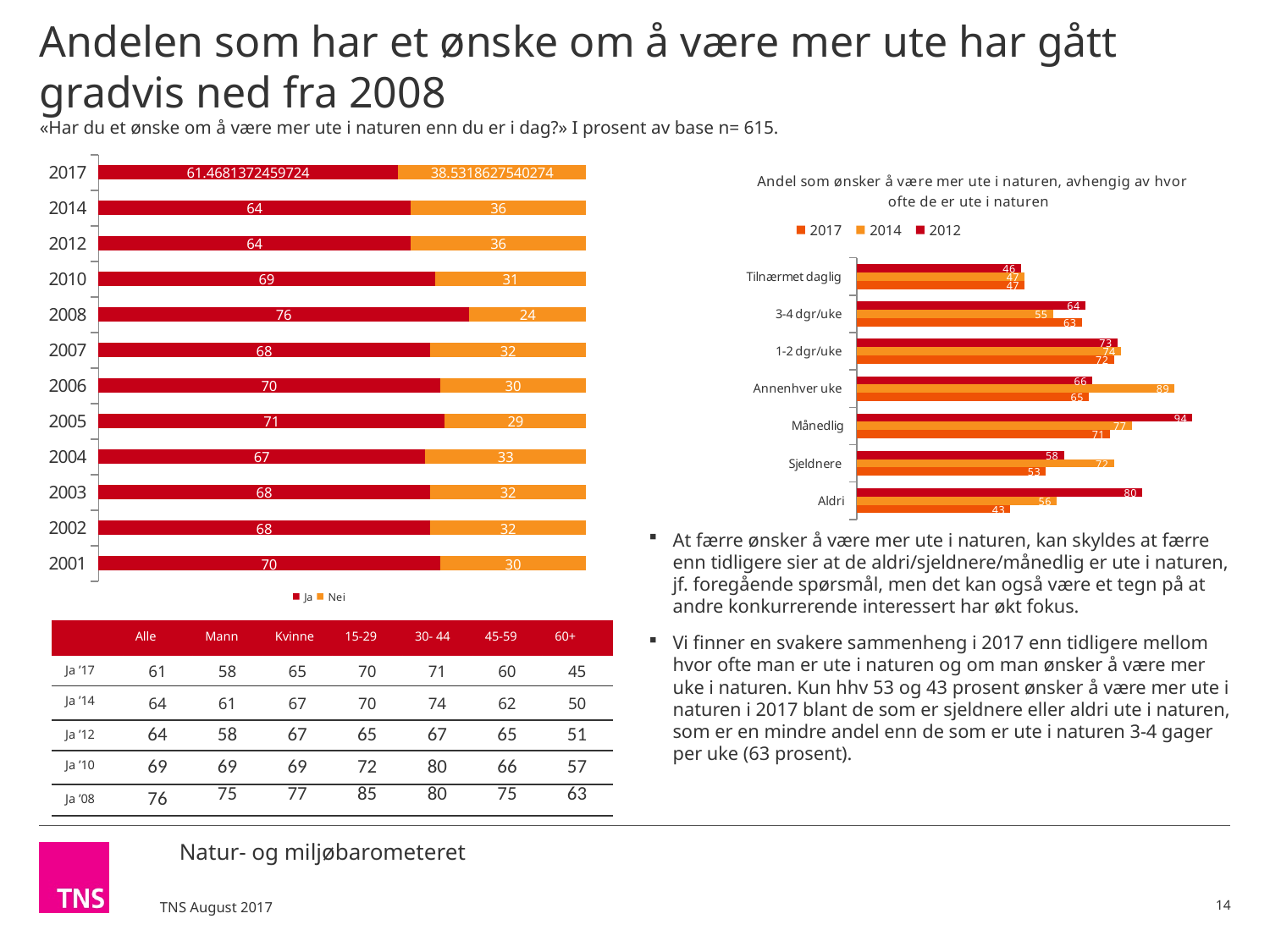
In the left stacked bar chart, what is the 'Nei' value for 2010? 31 In the left stacked bar chart, what is the 'Ja' value for 2008? 76 In the chart 'Andel som ønsker å være mer ute i naturen, avhengig av hvor ofte de er ute i naturen', how many series does the legend list? 3 In the chart 'Andel som ønsker å være mer ute i naturen, avhengig av hvor ofte de er ute i naturen', which category has the highest 2012 value? Månedlig What type of chart is the chart on the left side of the slide? Stacked bar chart In the left stacked bar chart, which year has the lowest 'Ja' value? 2017 In the left stacked bar chart, which year has the highest 'Ja' value? 2008 In the chart 'Andel som ønsker å være mer ute i naturen, avhengig av hvor ofte de er ute i naturen', what is the 2017 value for 'Aldri'? 43 In the left stacked bar chart, what is the difference between the 'Ja' values for 2008 and 2014? 12 In the left stacked bar chart, how many years are shown? 12 In the chart 'Andel som ønsker å være mer ute i naturen, avhengig av hvor ofte de er ute i naturen', what is the 2014 value for 'Annenhver uke'? 89 In the left stacked bar chart, how many series does the legend list? 2